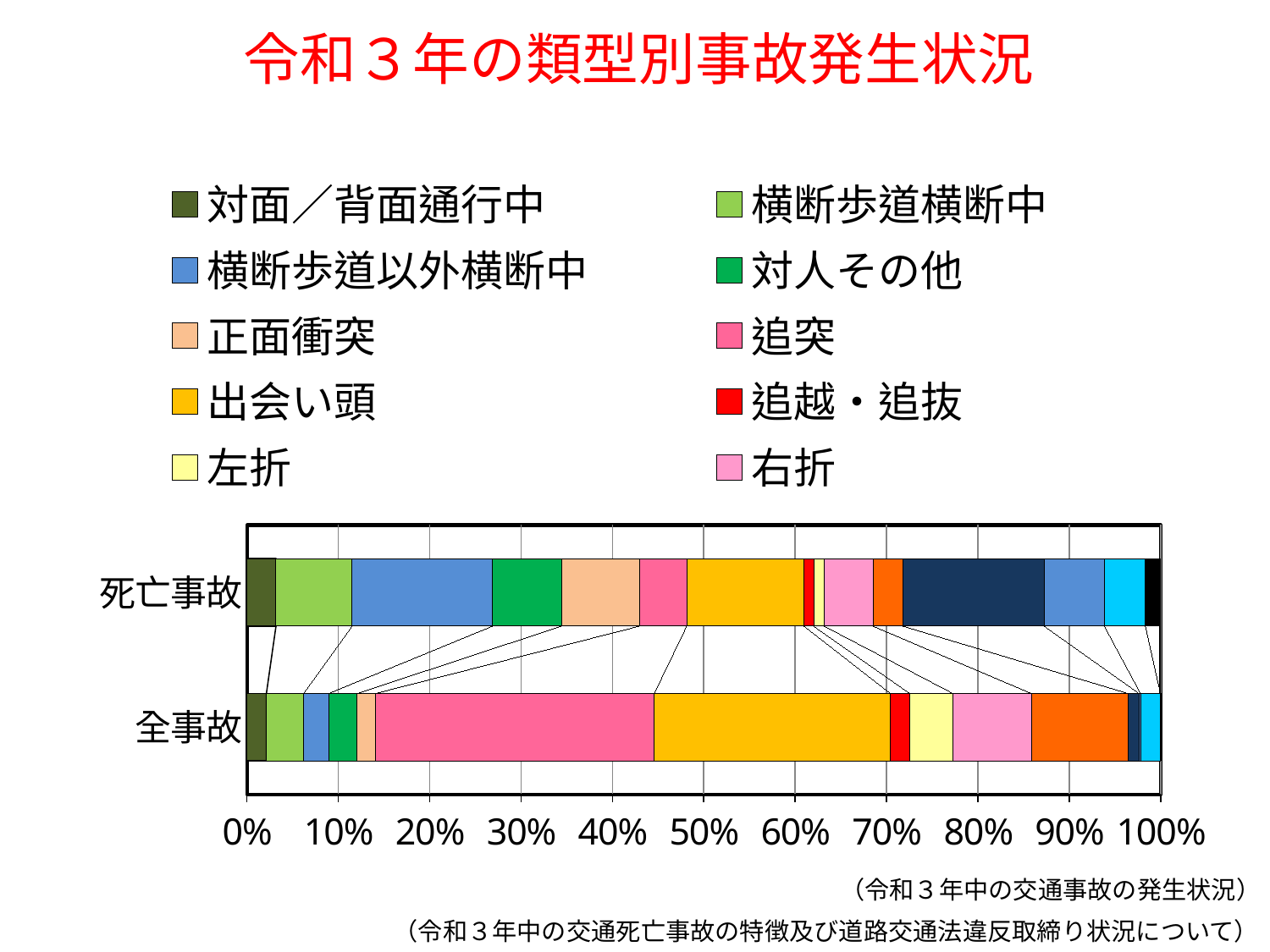
What is the title of the slide's chart? 令和３年の類型別事故発生状況 Which bar has the larger share for 追突, 死亡事故 or 全事故? 全事故 Is the share of 出会い頭 in the 全事故 bar greater or less than 20%? greater What are the two categories labelled on the vertical axis? 死亡事故 and 全事故 Is the share of 横断歩道以外横断中 in the 全事故 bar greater or less than 10%? less What kind of chart is shown on the slide? Stacked bar chart How many series does the legend list? 10 Is the share of 追突 in the 全事故 bar greater or less than 20%? greater How many bars (categories) does the chart show? 2 Which bar has the larger share for 横断歩道横断中, 死亡事故 or 全事故? 死亡事故 Which bar has the larger share for 横断歩道以外横断中, 死亡事故 or 全事故? 死亡事故